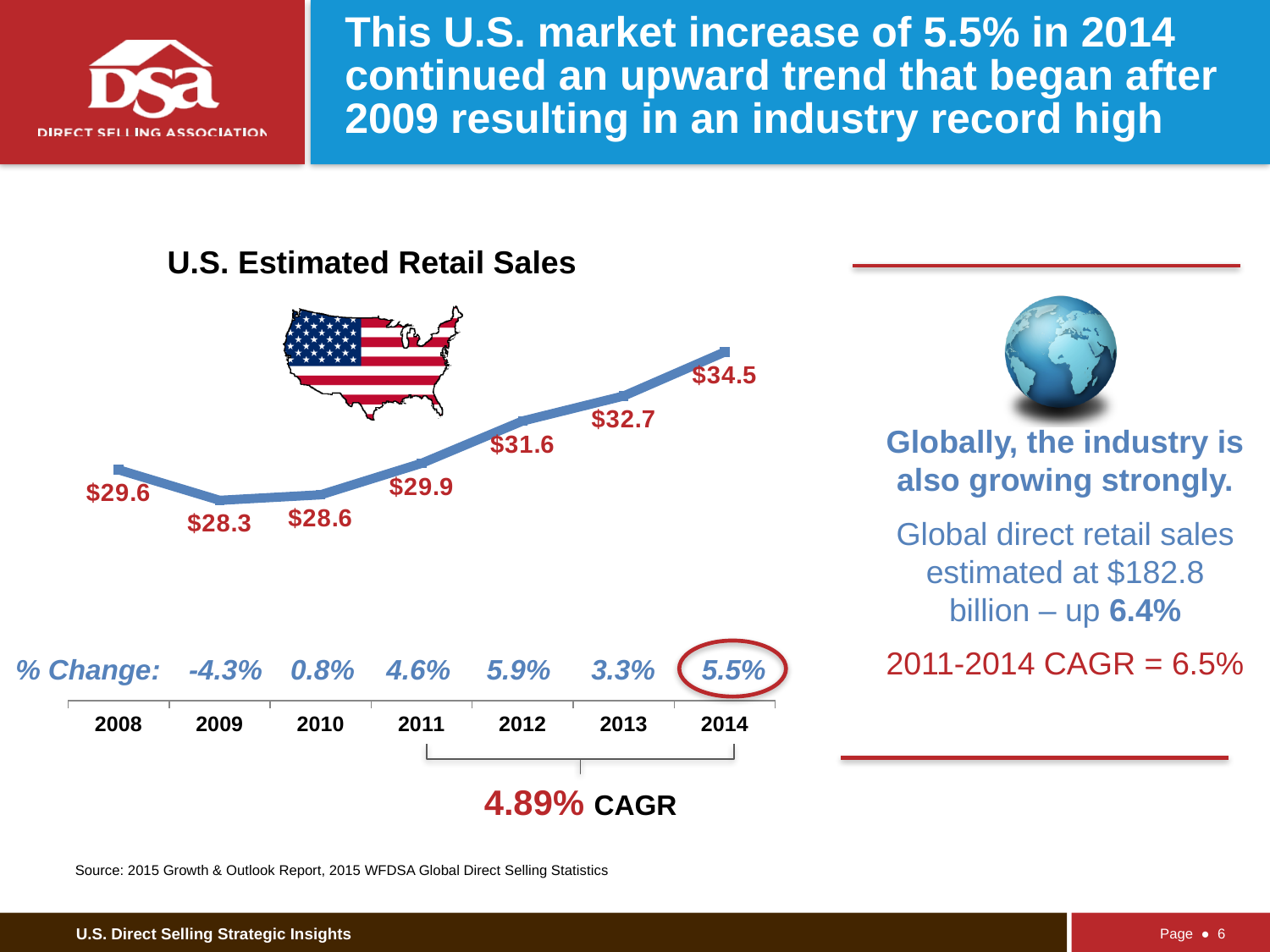
Which year has the lowest U.S. estimated retail sales? 2009 Which year has the highest U.S. estimated retail sales? 2014 How many years are plotted on the U.S. Estimated Retail Sales chart? 7 What is the U.S. estimated retail sales value for 2014? $34.5 What is the title of the chart on the slide? U.S. Estimated Retail Sales What is the % change shown for 2012 on the U.S. Estimated Retail Sales chart? 5.9% Do the U.S. estimated retail sales values rise or fall from 2009 to 2014? rise What is the U.S. estimated retail sales value for 2009? $28.3 What kind of chart is the U.S. Estimated Retail Sales chart? line chart What is the difference between the 2014 and 2013 U.S. estimated retail sales values? $1.8 Which year has a larger U.S. estimated retail sales value, 2008 or 2010? 2008 What is the U.S. estimated retail sales value for 2011? $29.9